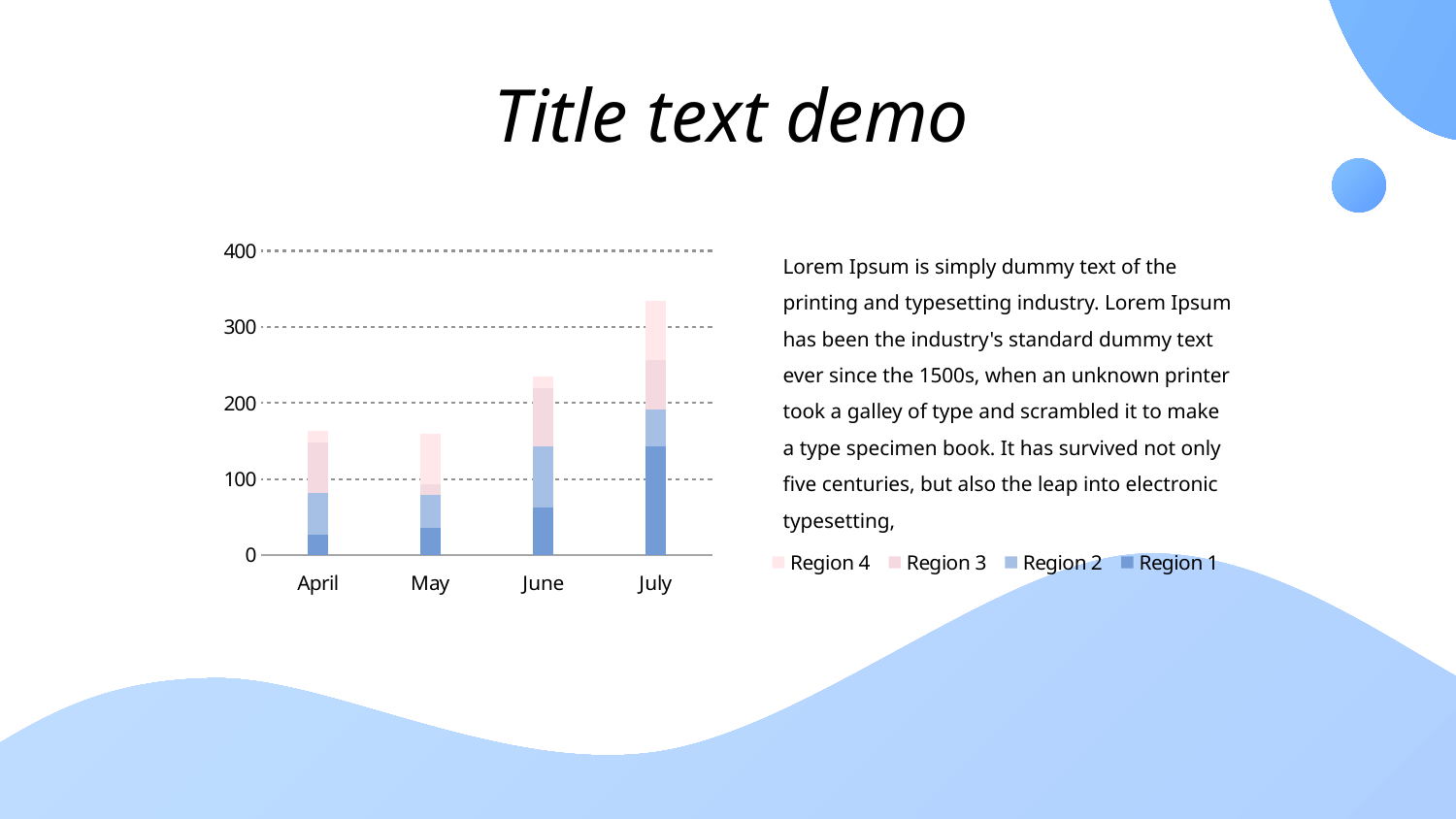
How many series does the chart's legend list? 4 What are the legend entries of the chart? Region 4, Region 3, Region 2, Region 1 Do the total stacked values rise or fall from May to July? rise Is the total stacked value for June greater or less than 200? greater Is the Region 1 value for July greater or less than 100? greater Is the total stacked value for July greater or less than 300? greater How many months are shown on the x axis of the chart? 4 What kind of chart is shown on the slide? Stacked bar chart Which month has the highest total stacked bar? July Which has the larger total stacked bar, June or May? June